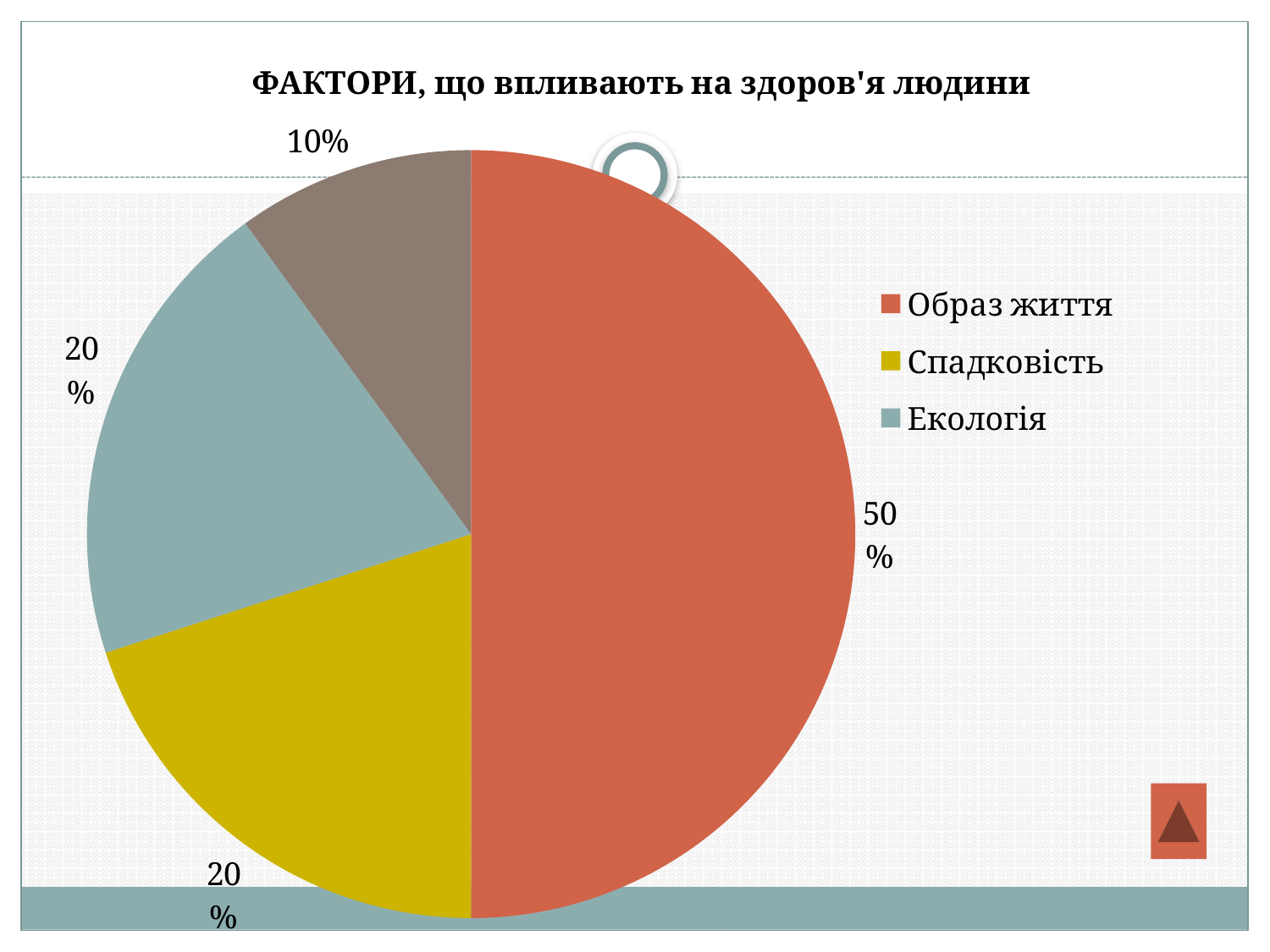
By how many percentage points is Образ життя larger than Спадковість? 30 percentage points How many entries does the legend list? 3 Which is larger, the slice for Образ життя or the slice for Екологія? Образ життя Which category has the largest slice of the pie? Образ життя What is the title of the chart? ФАКТОРИ, що впливають на здоров'я людини What percentage is shown for Екологія? 20% What percentage of the pie does Образ життя account for? 50% What kind of chart is shown on the slide? pie chart How many slices does the pie chart have? 4 What is the smallest percentage labelled on the pie? 10% What percentage is shown for Спадковість? 20% What colour is the slice for Спадковість in the legend? yellow